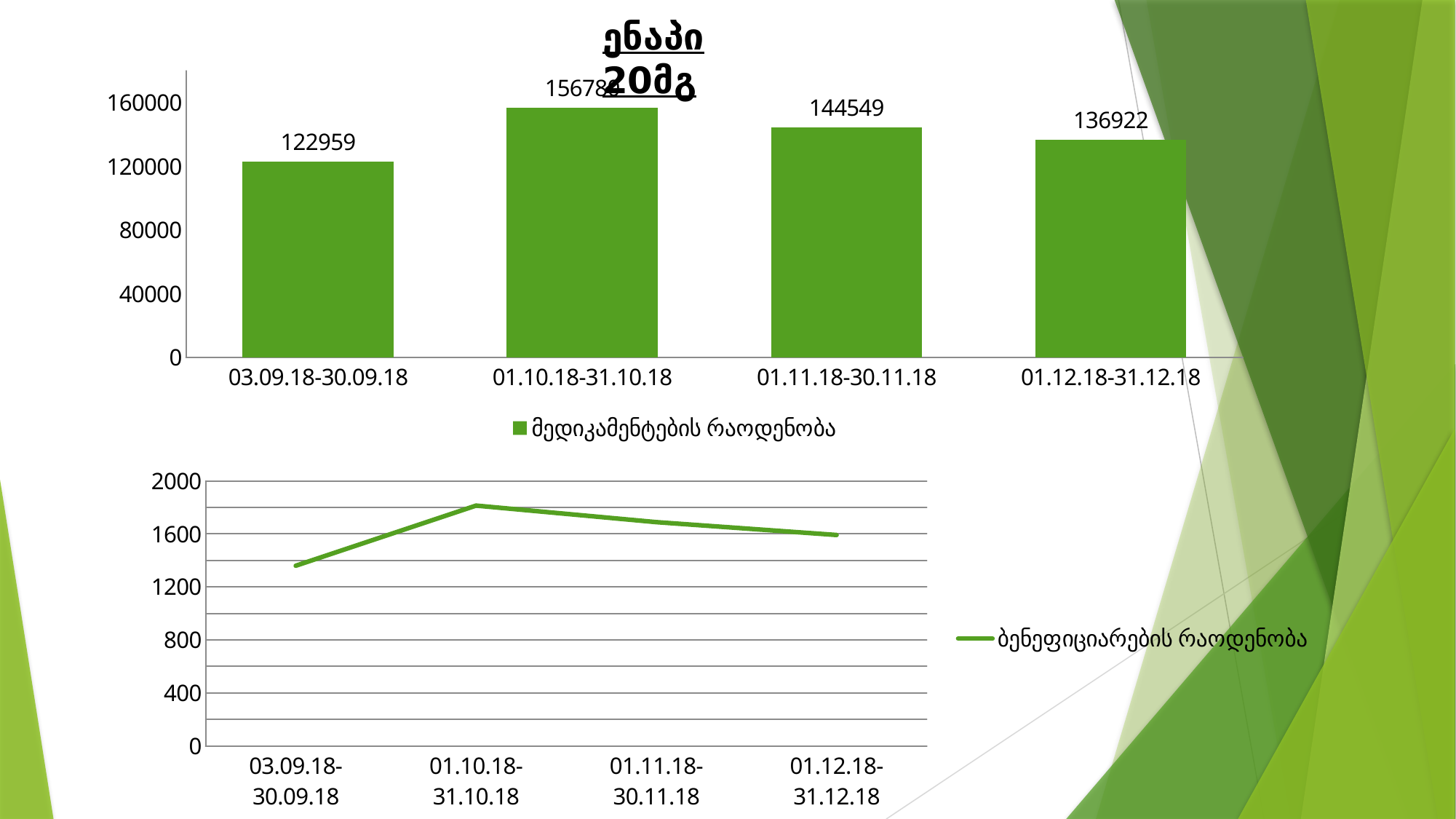
In the top bar chart, which is larger: the value for 03.09.18-30.09.18 or the value for 01.12.18-31.12.18? 01.12.18-31.12.18 In the top bar chart, what is the value for 01.12.18-31.12.18? 136922 In the top bar chart, what is the value for 03.09.18-30.09.18? 122959 How many bars are in the top bar chart? 4 In the top bar chart, what is the value for 01.11.18-30.11.18? 144549 In the top bar chart, which period has the highest value? 01.10.18-31.10.18 In the bottom line chart, is the value for 03.09.18-30.09.18 greater or less than 1600? less What kind of chart is the bottom chart on the slide? line chart What series name does the legend of the bottom line chart show? ბენეფიციარების რაოდენობა In the top bar chart, what is the difference between the values for 01.11.18-30.11.18 and 01.12.18-31.12.18? 7627 In the bottom line chart, is the value for 01.10.18-31.10.18 greater or less than 1600? greater In the top bar chart, which period has the lowest value? 03.09.18-30.09.18